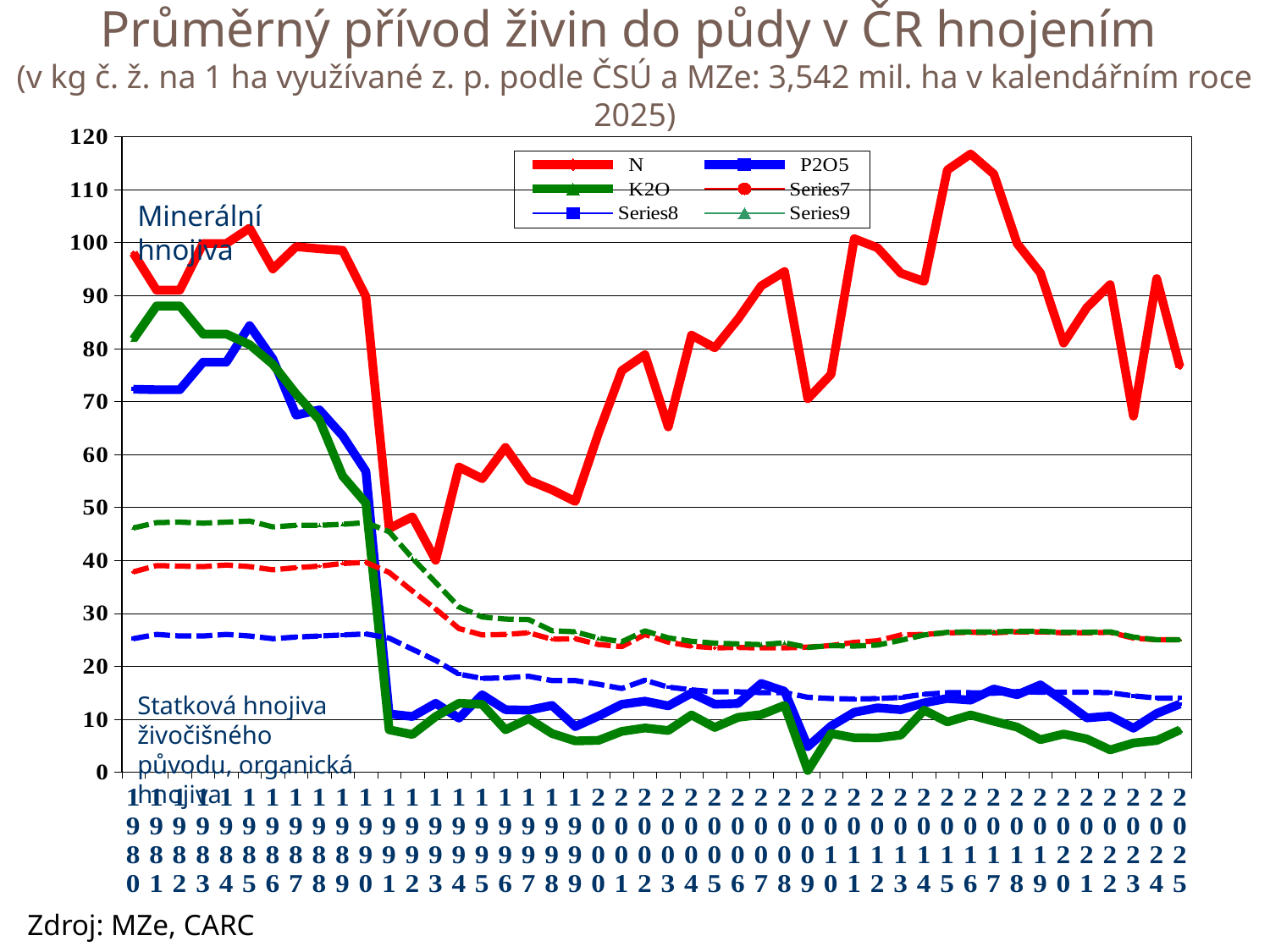
Is the value for K2O in 2009 greater or less than 10? less Which is larger in 2000, the value for N or the value for K2O? N Is the value for P2O5 in 1991 greater or less than 20? less What kind of chart is shown on the slide? line chart What is the source given at the bottom of the slide? Zdroj: MZe, CARC How many series does the legend list? 6 Is the value for N in 1980 greater or less than 90? greater How many years are shown along the x axis? 46 Which series has the lowest value in 2009? K2O Does the value for N rise or fall between 1980 and 1991? fall Which series has the highest value in 2016? N